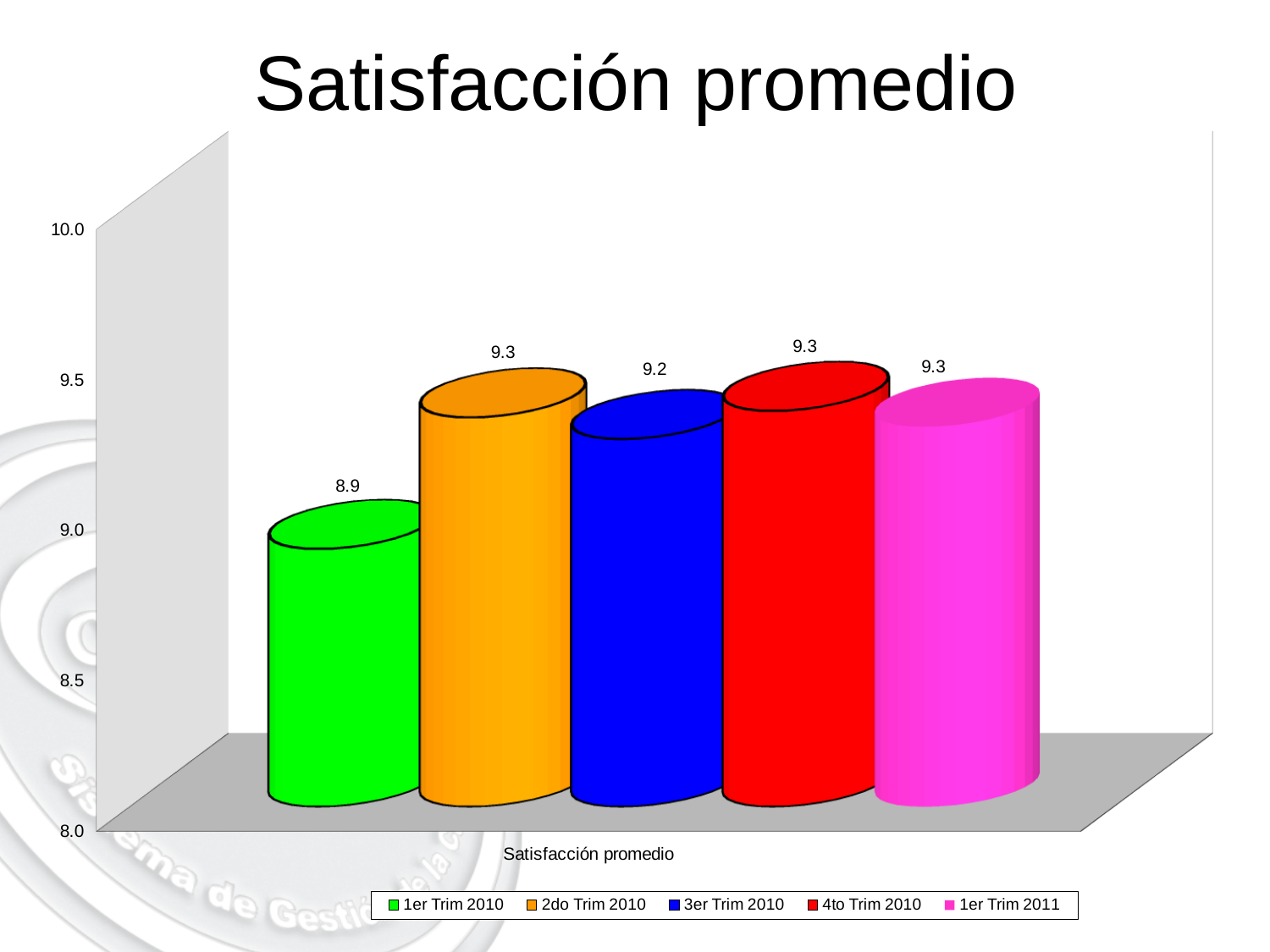
Is the value for 1er Trim 2010 greater or less than 8.5? greater Which is larger, the value for 3er Trim 2010 or the value for 1er Trim 2010? 3er Trim 2010 What kind of chart is shown on the slide? bar chart What is the title of the chart? Satisfacción promedio What is the value for 3er Trim 2010? 9.2 What is the difference between the values for 2do Trim 2010 and 1er Trim 2010? 0.4 What is the difference between the values for 4to Trim 2010 and 3er Trim 2010? 0.1 Which series has the lowest value? 1er Trim 2010 How many series does the legend list? 5 Is the value for 2do Trim 2010 greater or less than 9.5? less What is the value for 1er Trim 2011? 9.3 What is the value for 1er Trim 2010? 8.9